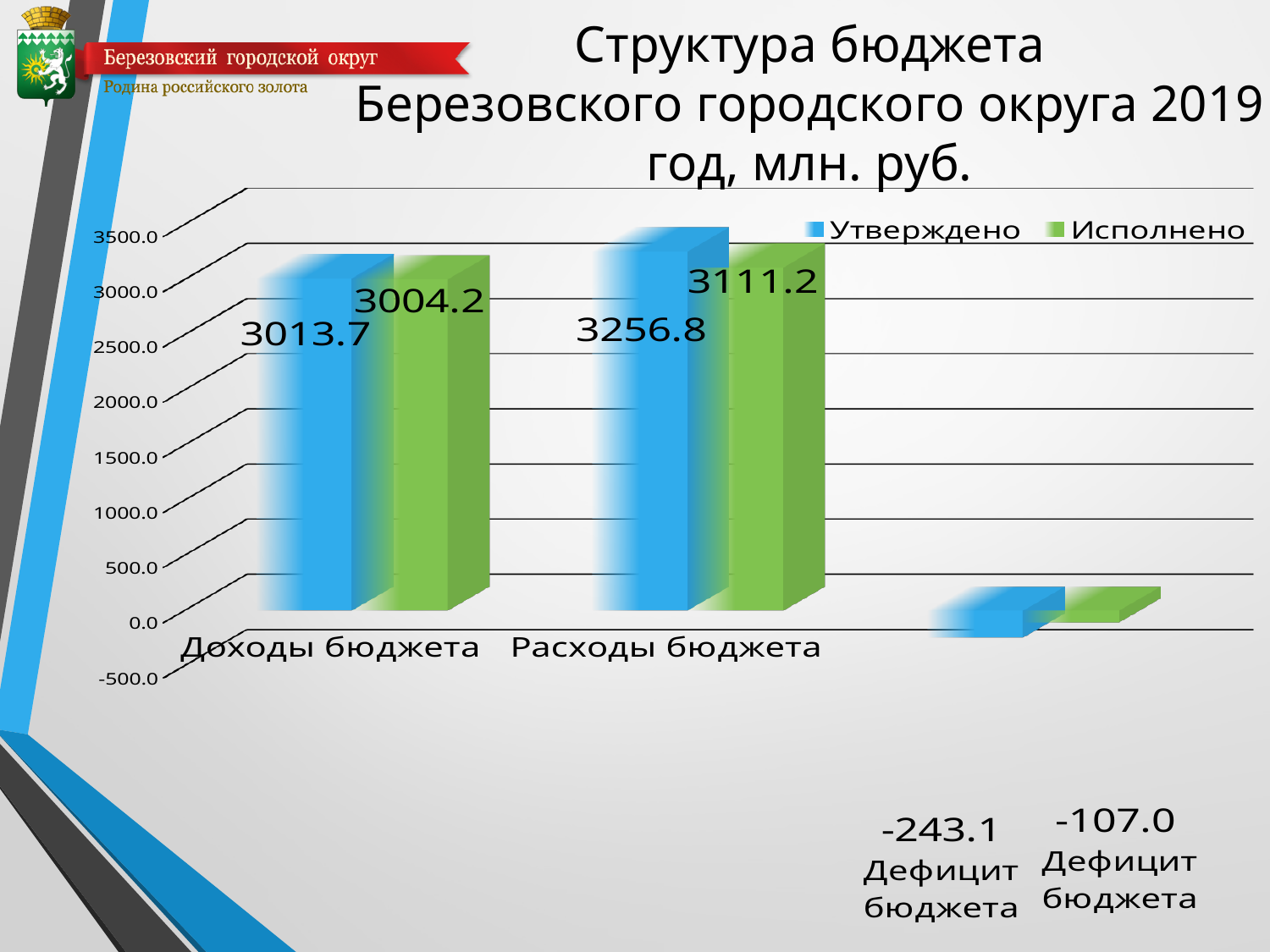
Which is larger for Доходы бюджета: the approved (Утверждено) value or the executed (Исполнено) value? Утверждено Which category has the lowest executed (Исполнено) value? Дефицит бюджета How many series does the legend list? 2 What is the approved (Утверждено) value for Дефицит бюджета? -243.1 What is the difference between the approved and executed values for Расходы бюджета? 145.6 Which colour represents the Исполнено series in the chart? Green What kind of chart is shown on the slide? Bar chart What is the approved (Утверждено) value for Доходы бюджета? 3013.7 What is the executed (Исполнено) value for Доходы бюджета? 3004.2 Which category has the highest approved (Утверждено) value? Расходы бюджета How many categories are shown on the x axis of the chart? 3 What is the executed (Исполнено) value for Расходы бюджета? 3111.2